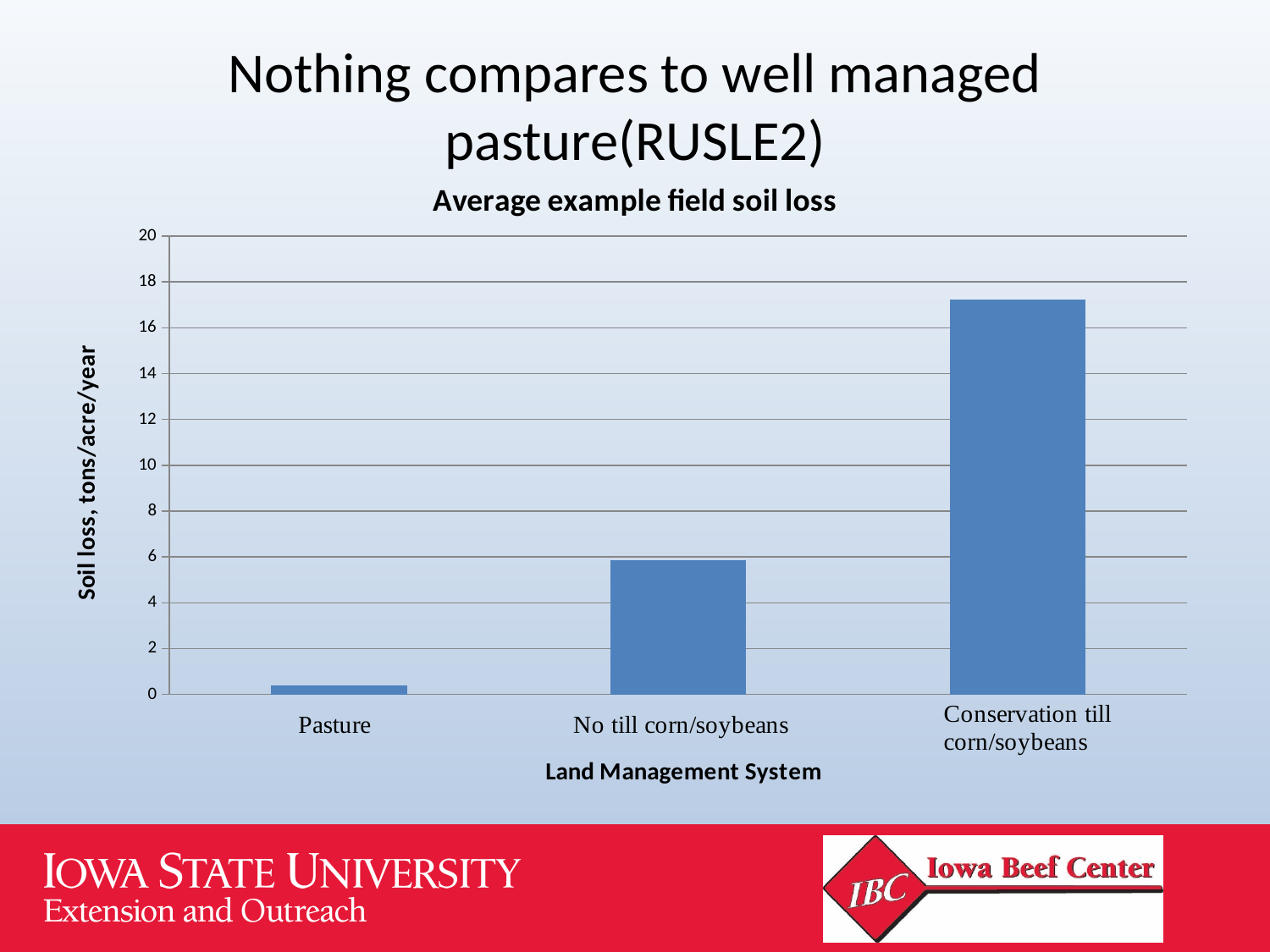
Which land management system has the highest soil loss? Conservation till corn/soybeans What is the title of the chart? Average example field soil loss What kind of chart is shown on the slide? bar chart Which has a larger soil loss, No till corn/soybeans or Pasture? No till corn/soybeans How many land management systems are plotted in the chart? 3 What is the label of the vertical axis? Soil loss, tons/acre/year Is the soil loss for Conservation till corn/soybeans greater or less than 16 tons/acre/year? greater Is the soil loss for Pasture greater or less than 2 tons/acre/year? less Do the soil loss values rise or fall moving from left to right across the categories? rise Is the soil loss for Conservation till corn/soybeans greater or less than 18 tons/acre/year? less Which land management system has the lowest soil loss? Pasture